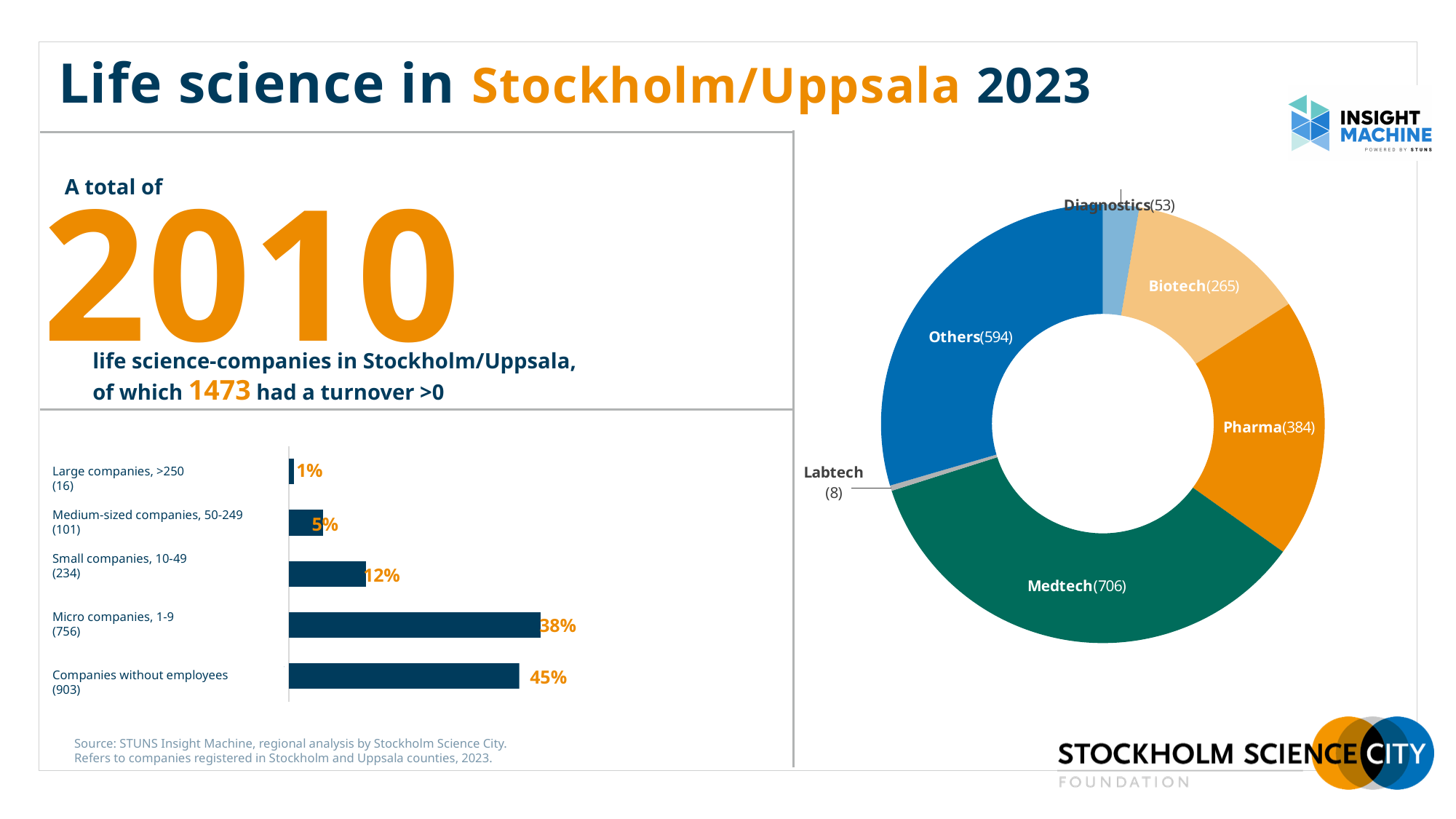
In the bar chart on the left, what percentage is shown for Micro companies, 1-9? 38% In the bar chart on the left, which category has the highest percentage? Companies without employees In the donut chart on the right, how many companies are in Medtech? 706 In the bar chart on the left, what percentage is shown for Companies without employees? 45% In the donut chart on the right, what is the difference between the number of Others companies and Pharma companies? 210 What type of chart is the chart on the left showing company sizes? Bar chart In the bar chart on the left, how many company-size categories are shown? 5 In the bar chart on the left, what is the difference in percentage points between Companies without employees and Micro companies, 1-9? 7 In the donut chart on the right, which is larger, Pharma or Biotech? Pharma In the donut chart on the right, which sector has the largest number of companies? Medtech In the donut chart on the right, how many companies are in Labtech? 8 In the bar chart on the left, which category has the lowest percentage? Large companies, >250